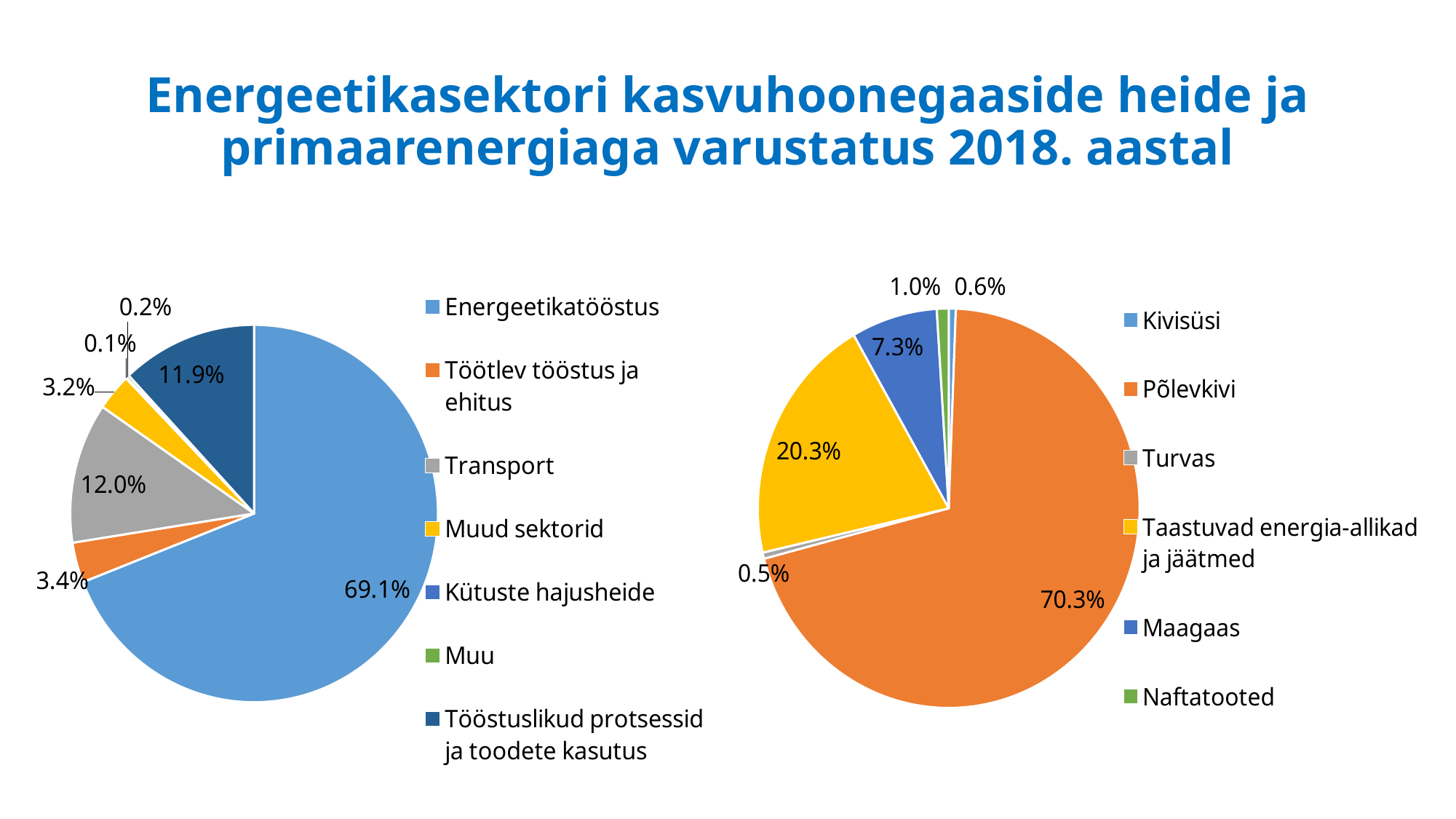
In the right pie chart, which is larger, Maagaas or Naftatooted? Maagaas In the right pie chart, which category has the largest share? Põlevkivi In the right pie chart, what is the value for Maagaas? 7.3% In the right pie chart, what is the value for Taastuvad energia-allikad ja jäätmed? 20.3% In the left pie chart, what is the difference between Transport and Tööstuslikud protsessid ja toodete kasutus? 0.1% How many categories does the legend of the left pie chart list? 7 In the left pie chart, what is the value for Tööstuslikud protsessid ja toodete kasutus? 11.9% In the left pie chart, what is the value for Transport? 12.0% In the left pie chart, which category has the smallest share? Kütuste hajusheide In the left pie chart, what share does Energeetikatööstus have? 69.1% In the right pie chart, what share does Põlevkivi have? 70.3% What type of chart is the right chart? Pie chart